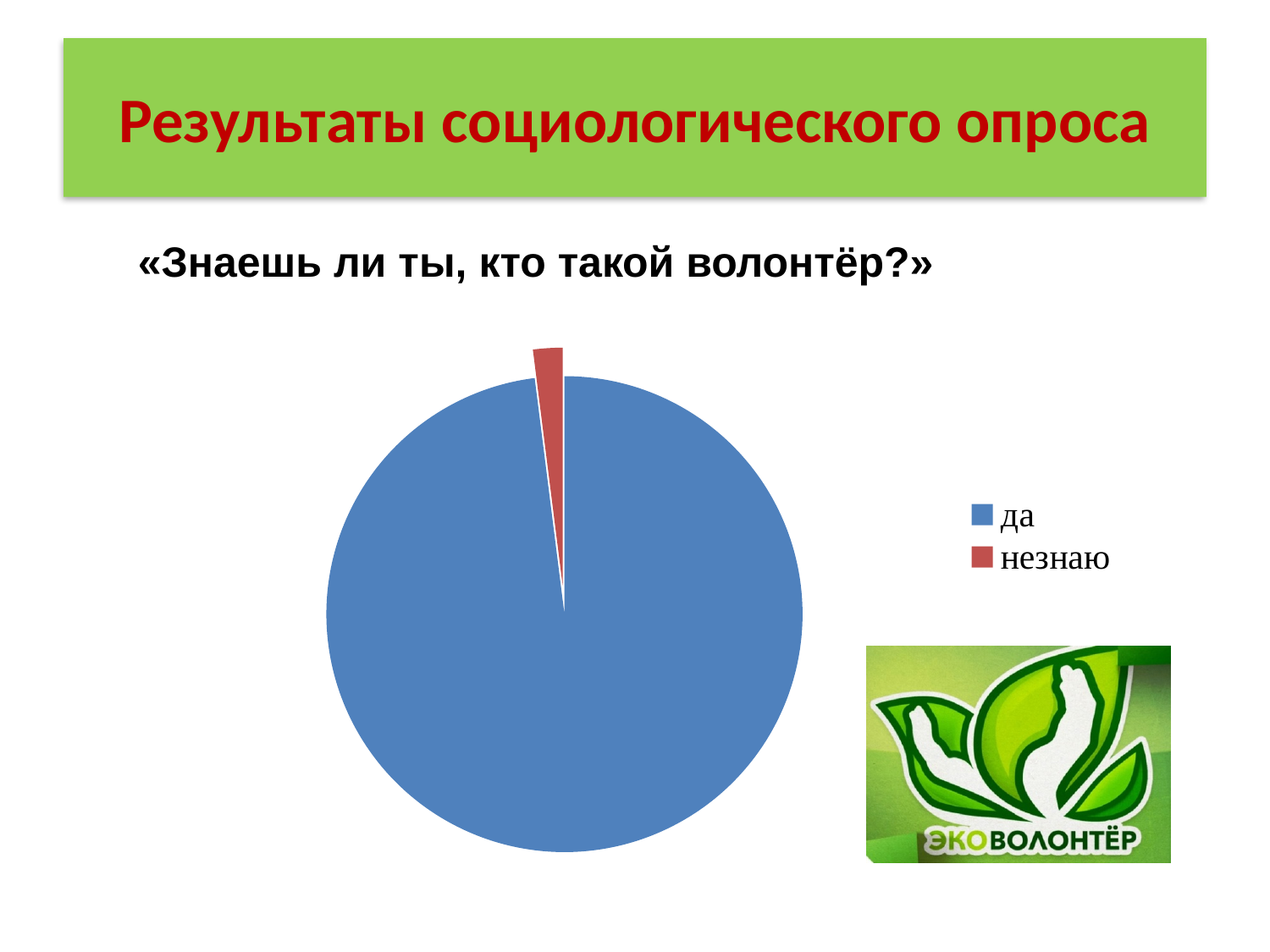
Which slice is larger in the pie chart, "да" or "незнаю"? да What colour is the slice for "да" in the pie chart? blue How many slices does the pie chart have? 2 Which category has the smallest slice in the pie chart? незнаю What survey question is the pie chart about? «Знаешь ли ты, кто такой волонтёр?» Which category has the largest slice in the pie chart? да How many entries does the legend of the pie chart list? 2 What kind of chart is shown on the slide? pie chart